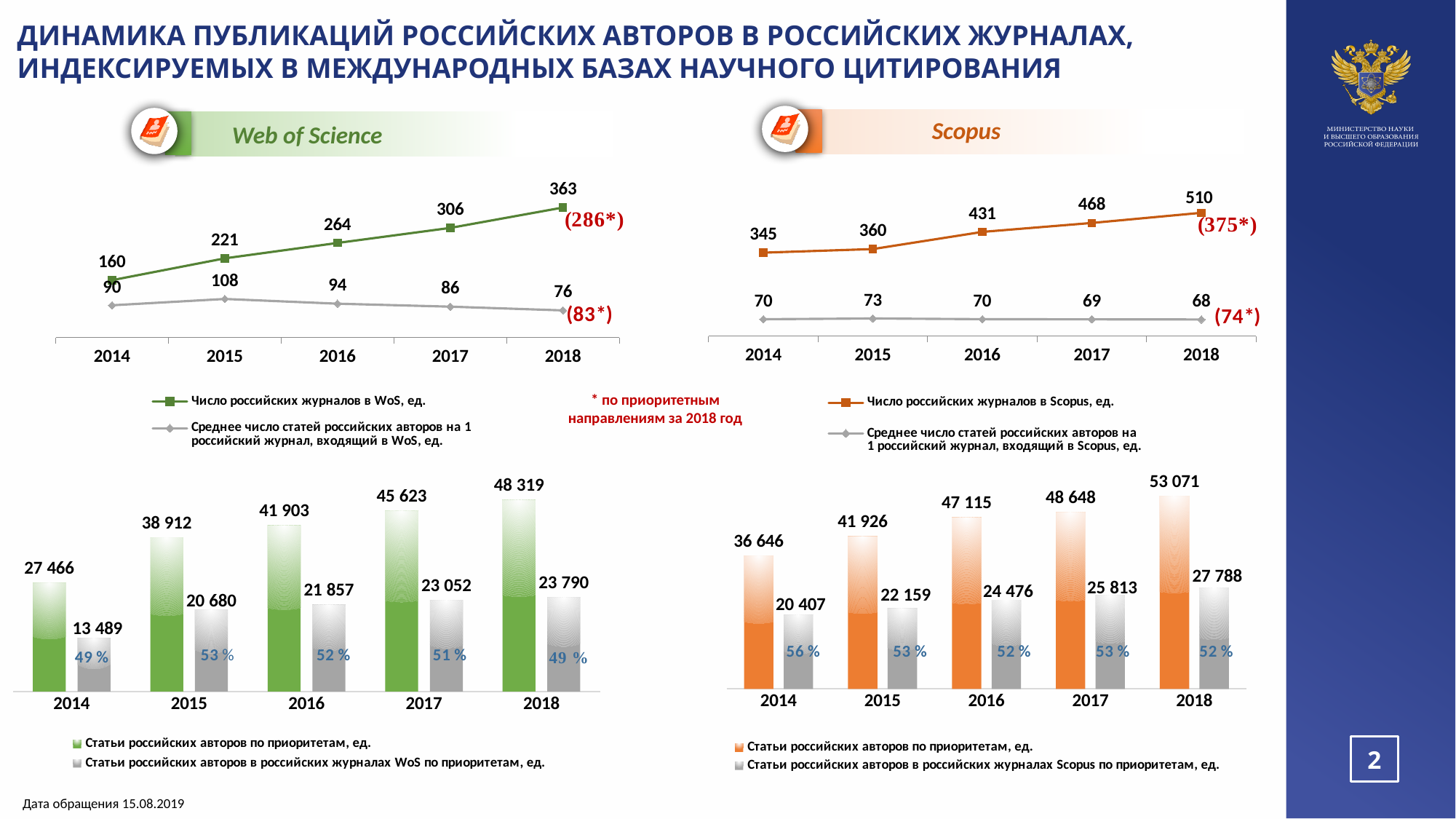
In the Web of Science line chart, what was the number of Russian journals in WoS in 2016? 264 What kind of chart is the bottom-left Web of Science chart? bar chart In the Scopus bar chart, which year has the larger value for articles in Russian Scopus journals by priorities: 2014 or 2015? 2015 In the Web of Science line chart, does the number of Russian journals in WoS rise or fall from 2014 to 2018? rises In the Scopus line chart, by how much did the number of Russian journals in Scopus grow from 2014 to 2018? 165 In the Scopus bar chart, how many articles by Russian authors in Russian Scopus journals by priorities were there in 2017? 25 813 How many series does the legend of the Web of Science bar chart list? 2 In the Scopus line chart, what was the number of Russian journals in Scopus in 2018? 510 In the Scopus bar chart, what percentage is shown for 2014? 56 % In the Web of Science bar chart, how many articles by Russian authors by priorities were there in 2015? 38 912 How many years are shown on the x axis of the Scopus line chart? 5 In the Web of Science line chart, which year had the highest average number of articles by Russian authors per Russian journal? 2015